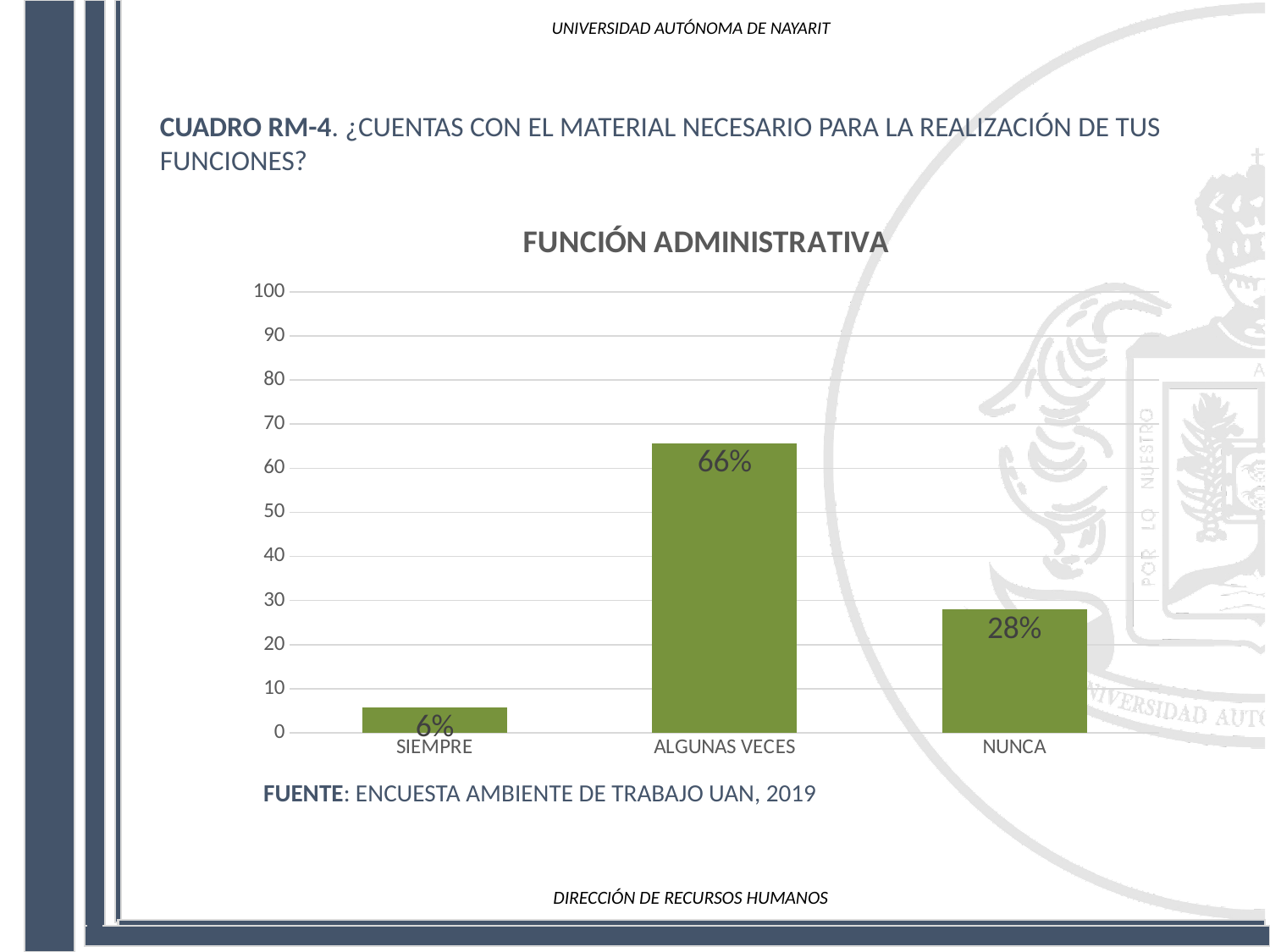
What is the difference between the values for NUNCA and SIEMPRE? 22% What is the value for ALGUNAS VECES? 66% How many categories are shown on the x axis? 3 What kind of chart is shown on the slide? bar chart What is the value for NUNCA? 28% Which category has the lowest value? SIEMPRE What is the value for SIEMPRE? 6% Which category has the highest value? ALGUNAS VECES What is the difference between the values for ALGUNAS VECES and NUNCA? 38% Which is larger, the value for NUNCA or the value for SIEMPRE? NUNCA Is the value for ALGUNAS VECES greater or less than 50? greater What is the title of the chart? FUNCIÓN ADMINISTRATIVA